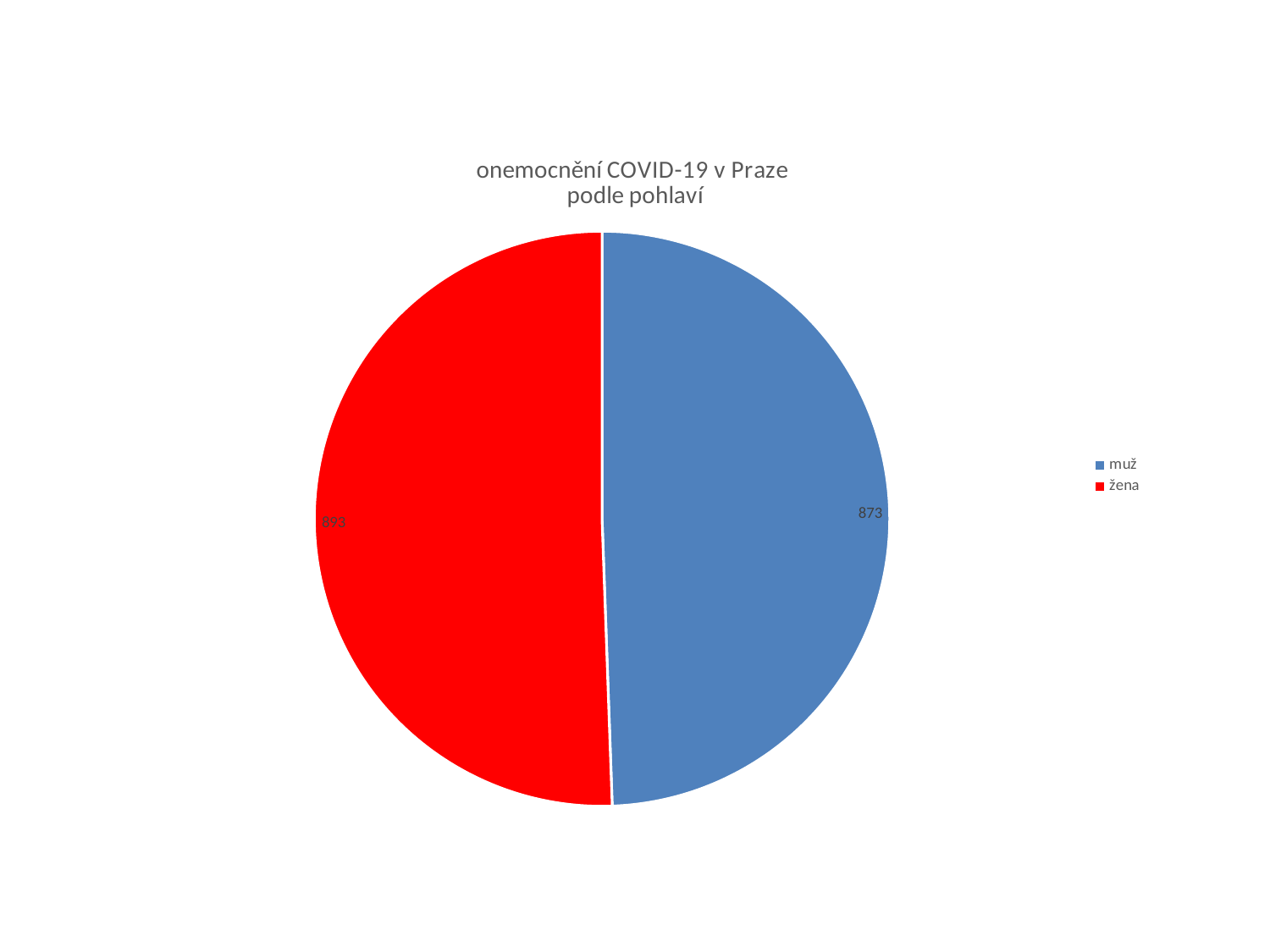
What kind of chart is shown on the slide? pie chart Which category has the larger value, muž or žena? žena How many slices does the pie chart have? 2 Which category has the highest value? žena Which colour represents žena in the chart? red What is the title of the chart? onemocnění COVID-19 v Praze podle pohlaví What is the value for muž? 873 What is the difference between the values for žena and muž? 20 What is the total of all slices in the pie chart? 1766 What is the value for žena? 893 Which category has the lowest value? muž How many entries does the legend list? 2